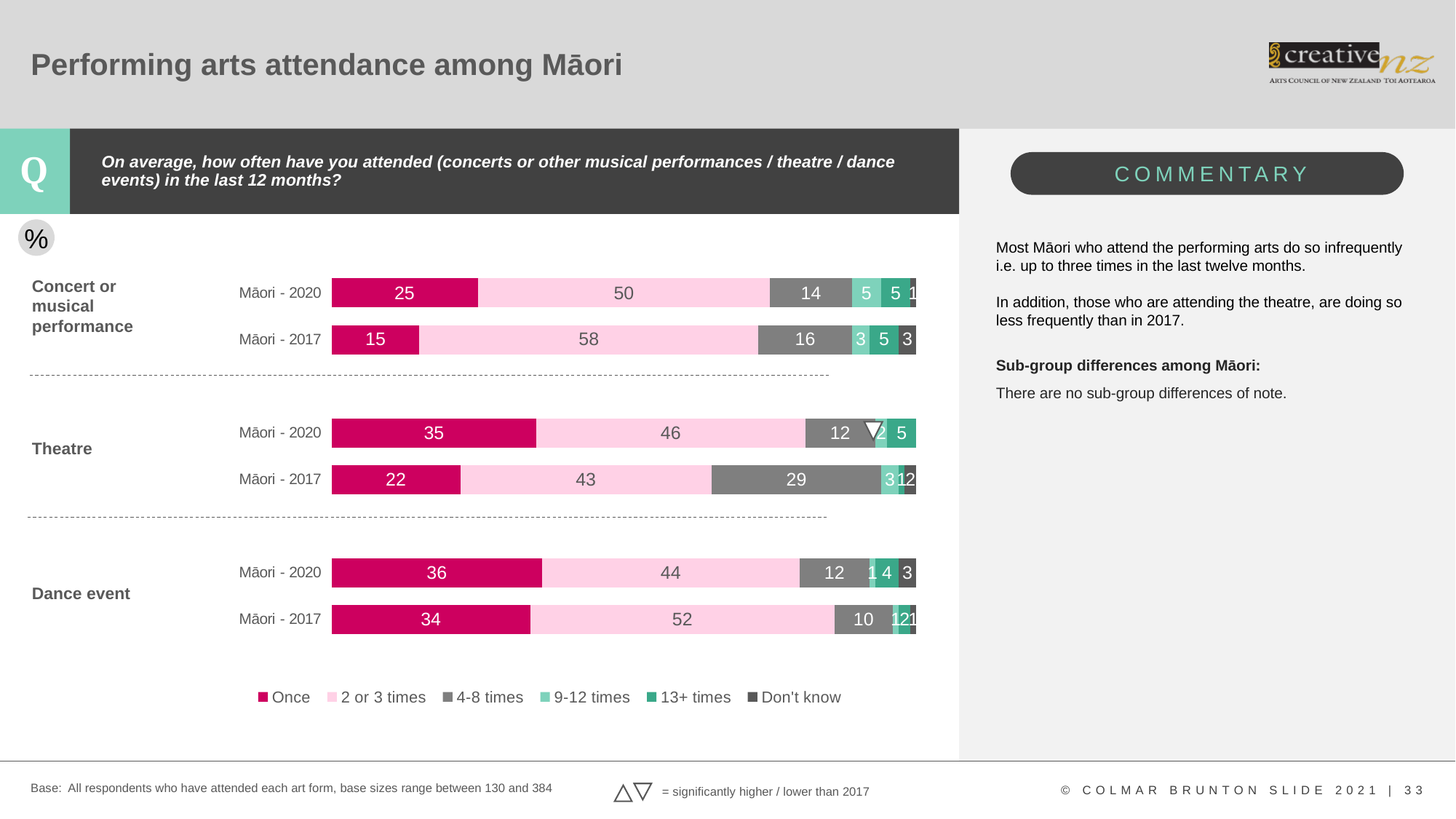
What is the '4-8 times' value for Theatre among Māori in 2017? 29 What is the 'Once' value for Dance event among Māori in 2020? 36 For Theatre, what is the '2 or 3 times' value for Māori - 2017? 43 Which has the larger '2 or 3 times' value: Concert or musical performance Māori - 2017 or Dance event Māori - 2017? Concert or musical performance Māori - 2017 What kind of chart is shown on the slide? Stacked bar chart What is the difference between the '2 or 3 times' values for Concert or musical performance in 2017 and 2020? 8 How many bars are plotted in the chart? 6 What percentage of Māori in 2020 attended a concert or musical performance once? 25 By how many percentage points did the 'Once' value for Theatre change from Māori - 2017 to Māori - 2020? 13 What is the '4-8 times' value for Dance event among Māori in 2017? 10 How many series does the legend list? 6 Which bar has the highest 'Once' value? Dance event, Māori - 2020